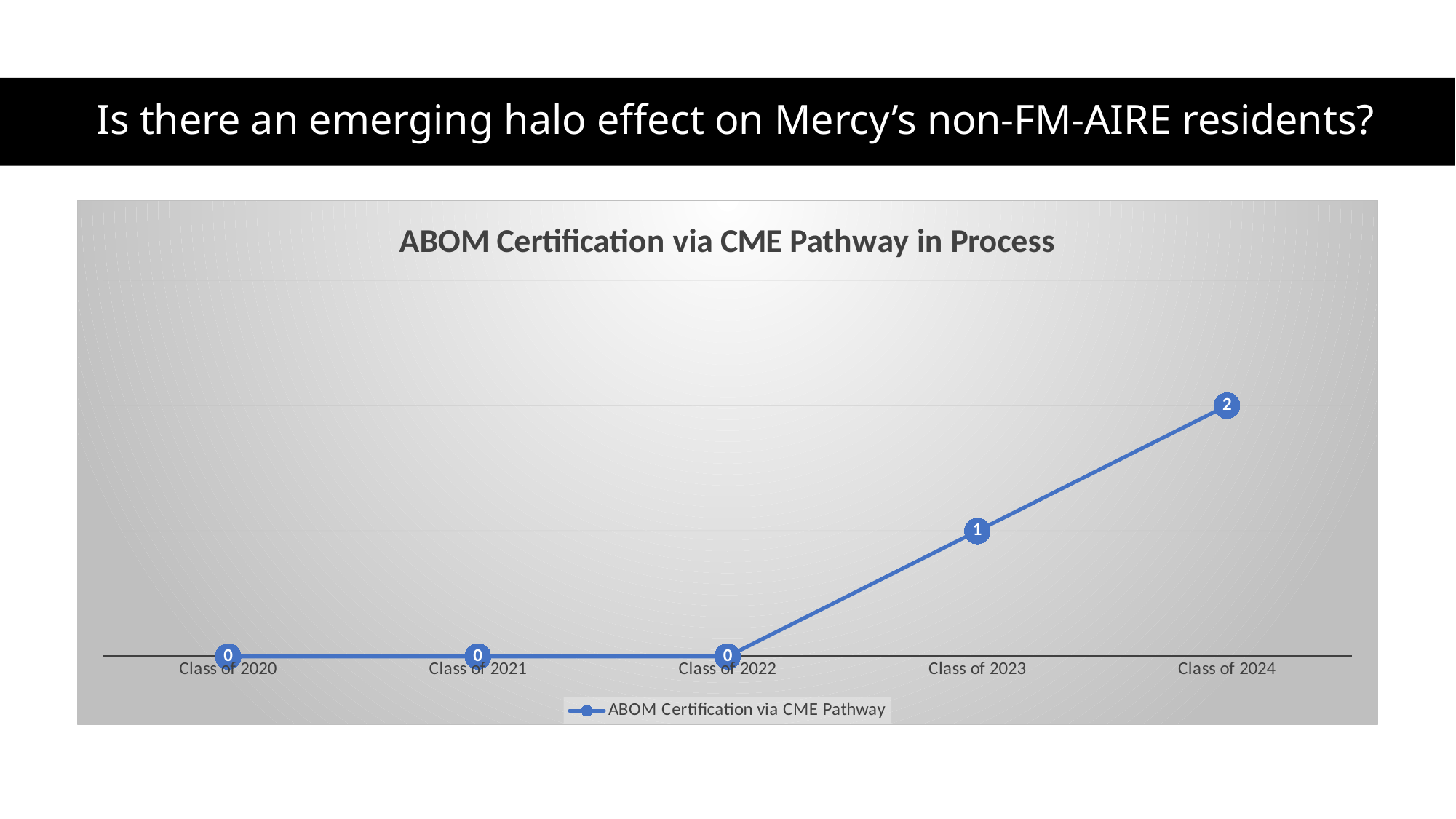
What kind of chart is shown? line chart How many classes are plotted on the x axis? 5 How many series does the legend list? 1 Which class has the highest value? Class of 2024 What is the title of the chart? ABOM Certification via CME Pathway in Process What is the difference between the values for Class of 2024 and Class of 2023? 1 What is the value for Class of 2022? 0 What is the value for Class of 2020? 0 Do the values rise or fall from Class of 2022 to Class of 2024? rise Which is larger, the value for Class of 2023 or the value for Class of 2022? Class of 2023 What is the value for Class of 2024? 2 What is the value for Class of 2023? 1